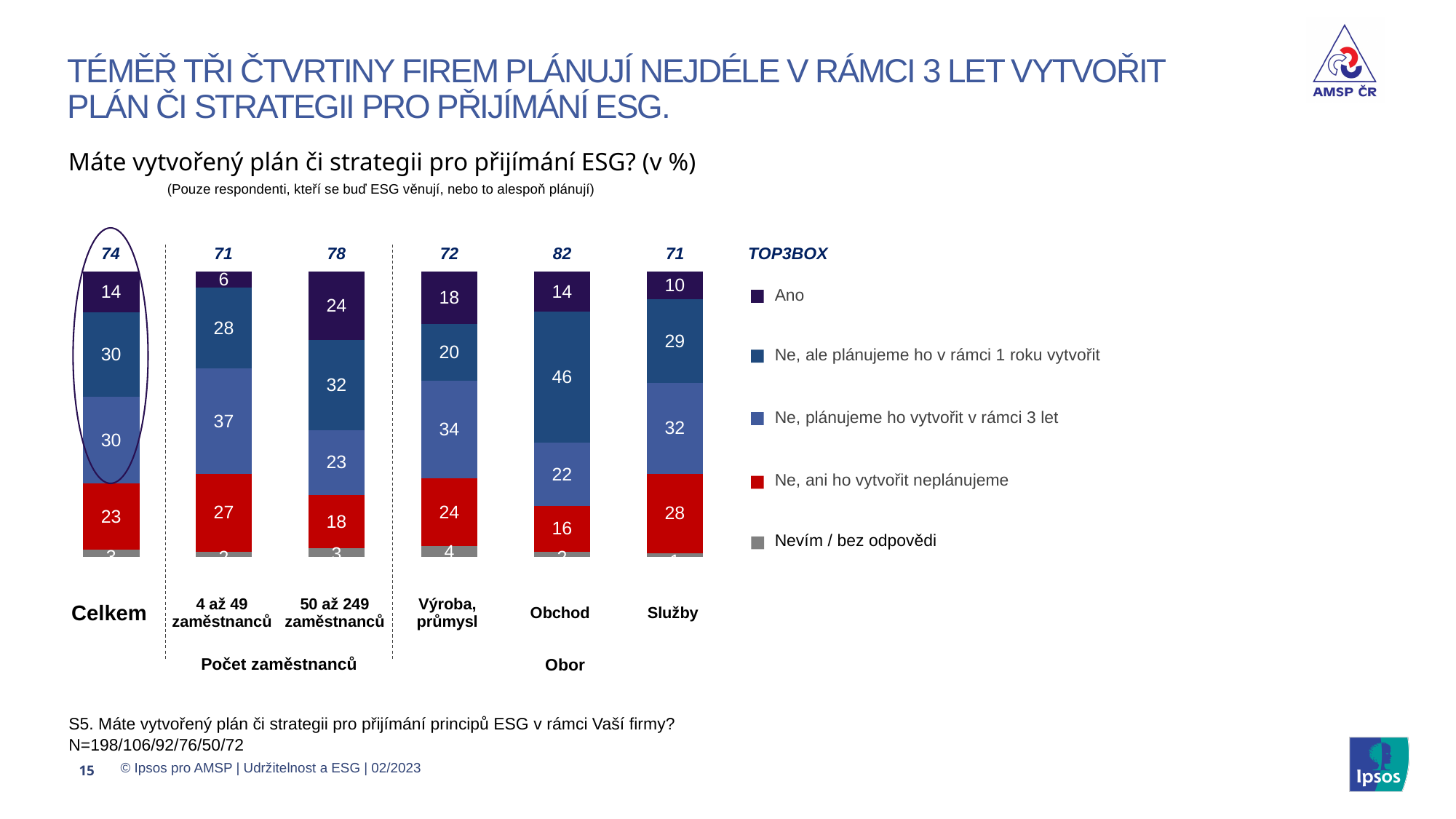
What is the difference in the 'Ano' value between '50 až 249 zaměstnanců' and '4 až 49 zaměstnanců'? 18 Which has a larger 'Ne, ani ho vytvořit neplánujeme' value: 'Služby' or 'Výroba, průmysl'? Služby Which category has the highest TOP3BOX value? Obchod What is the TOP3BOX value shown above the 'Výroba, průmysl' bar? 72 What is the value of 'Ne, ale plánujeme ho v rámci 1 roku vytvořit' for 'Obchod'? 46 What kind of chart is shown on the slide? Stacked bar chart How many series does the legend list? 5 Which category has the lowest 'Ano' value? 4 až 49 zaměstnanců What is the value of 'Ne, ani ho vytvořit neplánujeme' for 'Celkem'? 23 What is the TOP3BOX value shown above the 'Celkem' bar? 74 How many bars (categories) are plotted in the chart? 6 What is the value of 'Ano' for the '50 až 249 zaměstnanců' bar? 24